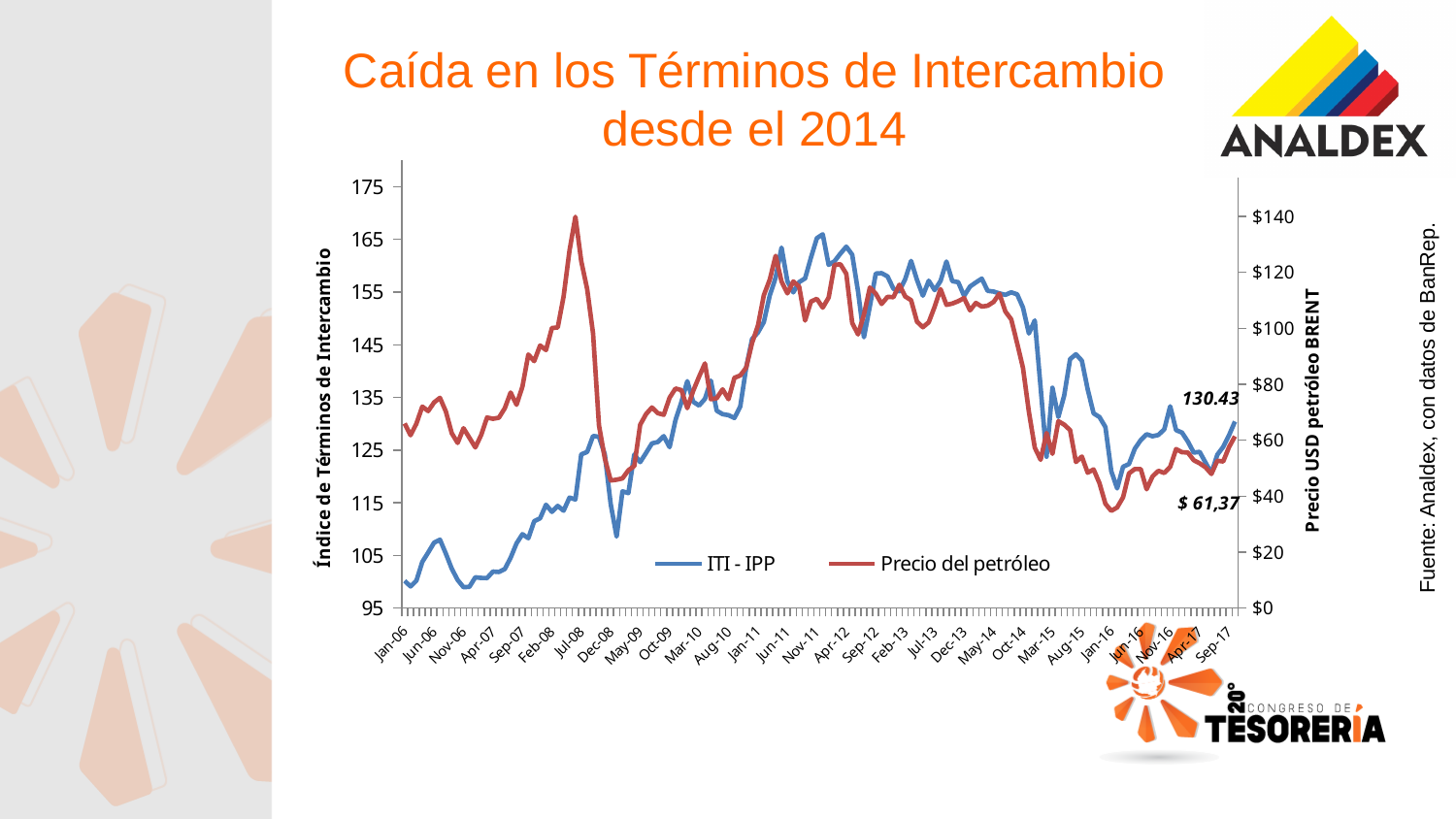
Is the value of Precio del petróleo around Jan-16 greater or less than $60? less Is the value of ITI - IPP at its dip around Dec-08 greater or less than 115? less What is the last labelled value of the ITI - IPP series? 130.43 Does the ITI - IPP series rise or fall between May-14 and Jan-16? fall What is the title of the chart's left vertical axis? Índice de Términos de Intercambio Does the ITI - IPP series rise or fall between Jan-06 and Jun-11? rise What are the two series named in the legend? ITI - IPP and Precio del petróleo What is the last labelled value of the Precio del petróleo series? $ 61,37 Is the value of ITI - IPP at Jan-06 greater or less than 105? less How many series does the chart's legend list? 2 What kind of chart is shown on the slide? line chart